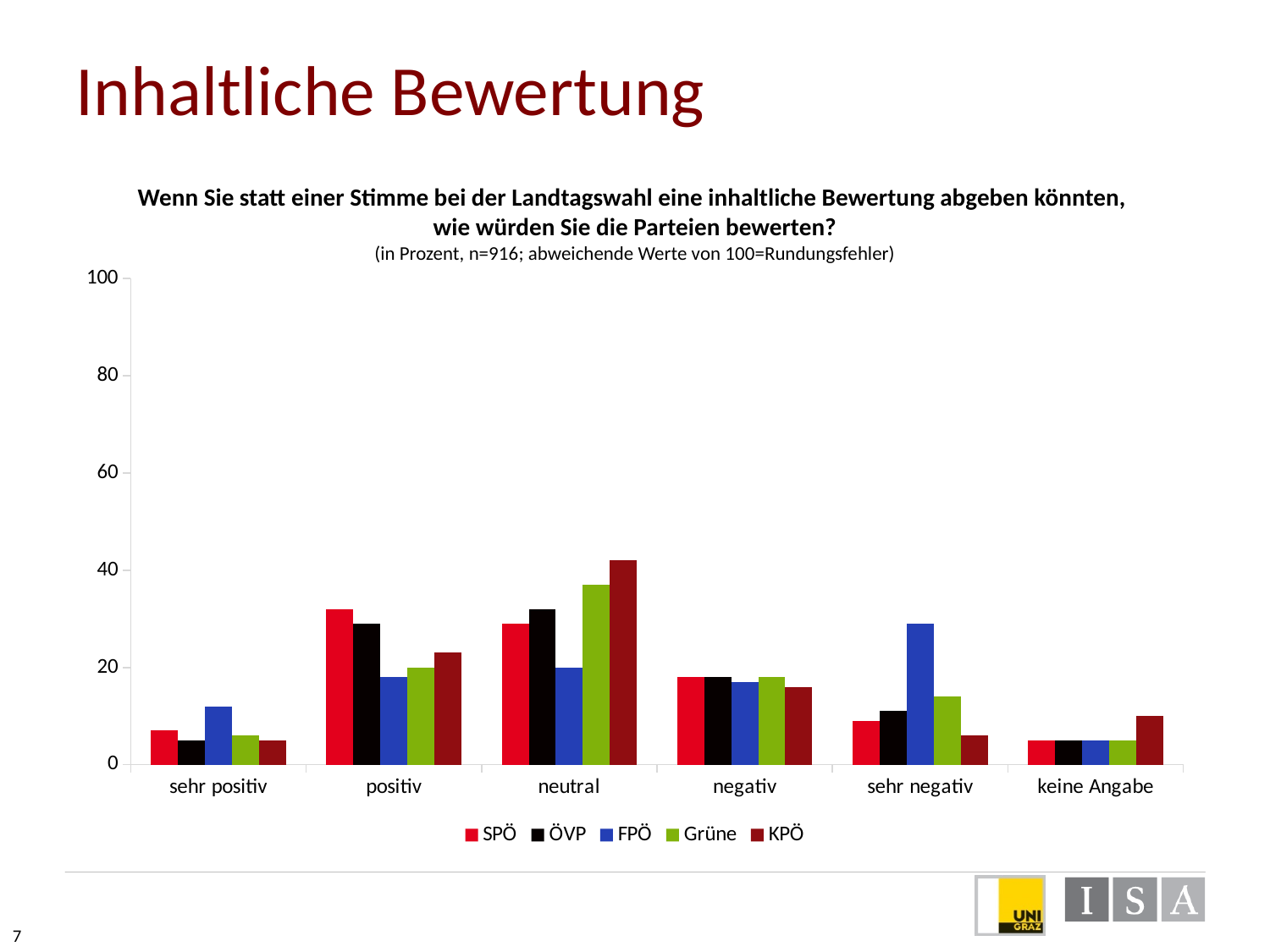
Is the value for FPÖ in the 'sehr negativ' category greater or less than 20? greater Which party has the highest value in the 'keine Angabe' category? KPÖ Is the value for SPÖ in the 'positiv' category greater or less than 20? greater Which party has the highest value in the 'sehr positiv' category? FPÖ In the 'positiv' category, which is larger: the value for SPÖ or the value for FPÖ? SPÖ What colour represents FPÖ in the legend? blue Which party has the highest value in the 'sehr negativ' category? FPÖ How many categories are shown on the x axis? 6 What kind of chart is shown on the slide? bar chart How many series does the legend list? 5 For Grüne, which category has the larger value: 'neutral' or 'positiv'? neutral